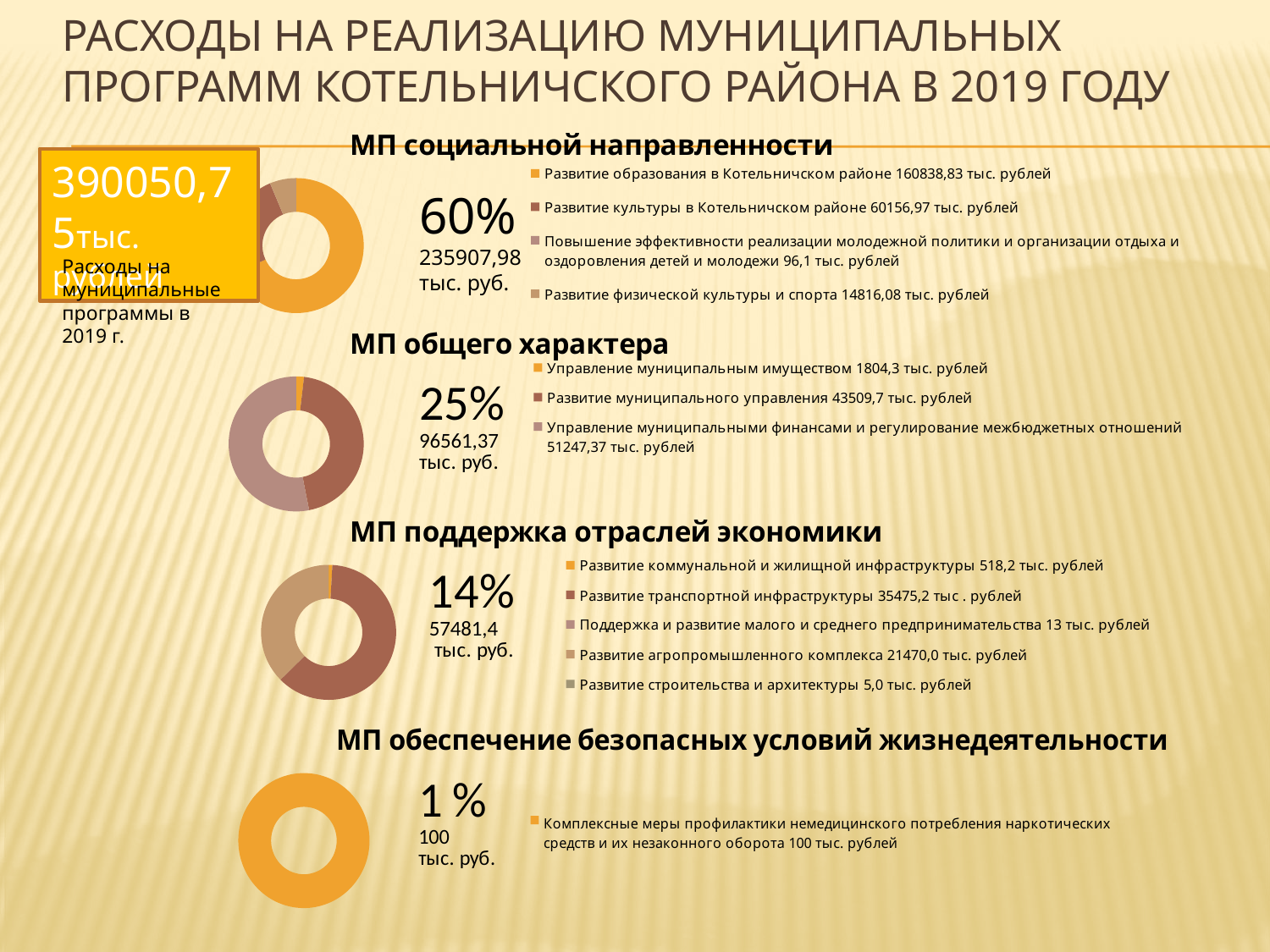
In the "МП общего характера" chart, what is the difference between "Управление муниципальными финансами и регулирование межбюджетных отношений" and "Развитие муниципального управления"? 7737,67 тыс. рублей What share of total expenditure does "МП обеспечение безопасных условий жизнедеятельности" represent? 1% In the "МП социальной направленности" chart, which program has the smallest value? Повышение эффективности реализации молодежной политики и организации отдыха и оздоровления детей и молодежи In the "МП поддержка отраслей экономики" chart, how many programs are listed in the legend? 5 In the "МП социальной направленности" chart, how many legend entries are listed? 4 What kind of chart is used for "МП социальной направленности"? Doughnut (pie) chart In the "МП поддержка отраслей экономики" chart, which is larger: "Развитие транспортной инфраструктуры" or "Развитие агропромышленного комплекса"? Развитие транспортной инфраструктуры What share of total expenditure does "МП социальной направленности" represent? 60% In the "МП общего характера" chart, what is the value for "Развитие муниципального управления"? 43509,7 тыс. рублей What is the total amount shown for "МП поддержка отраслей экономики"? 57481,4 тыс. руб. In the "МП общего характера" chart, which program has the largest value? Управление муниципальными финансами и регулирование межбюджетных отношений In the "МП социальной направленности" chart, what is the value for "Развитие образования в Котельничском районе"? 160838,83 тыс. рублей